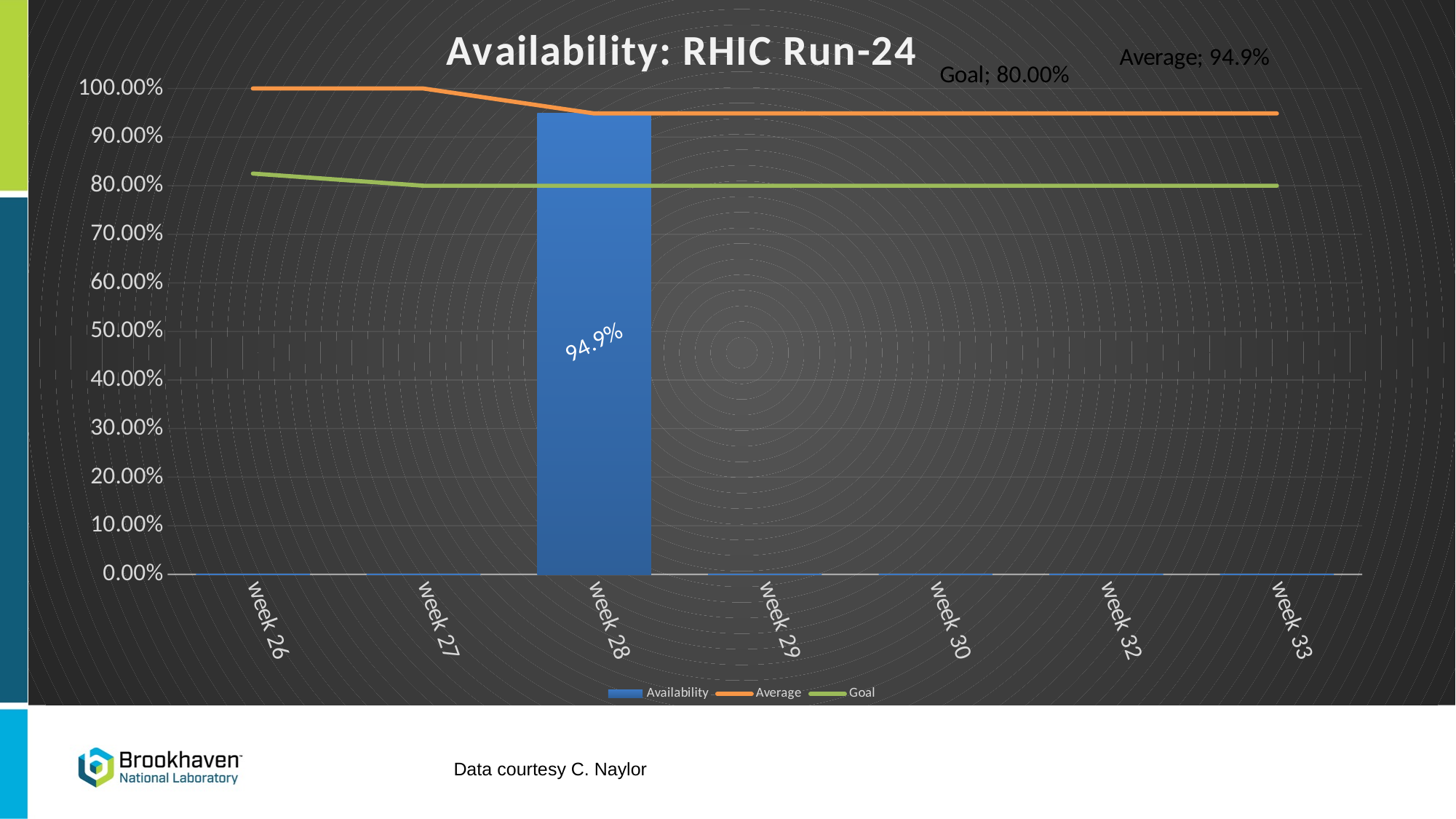
What is the Average value shown by the data label at the end of the Average line? 94.9% Does the Average line rise or fall from week 26 to week 28? falls Is the Average value at week 26 greater or less than 90.00%? greater How many week categories are shown on the x axis? 7 What is the Availability value for week 28? 94.9% What kind of chart is this? Combined bar and line chart How many series does the legend list? 3 What is the Goal value shown by the data label at the end of the Goal line? 80.00% What is the title of the chart? Availability: RHIC Run-24 At week 33, which is larger, the Average or the Goal? Average Is the Goal value at week 26 greater or less than 90.00%? less What is the difference between the labelled Average (94.9%) and the labelled Goal (80.00%)? 14.9%